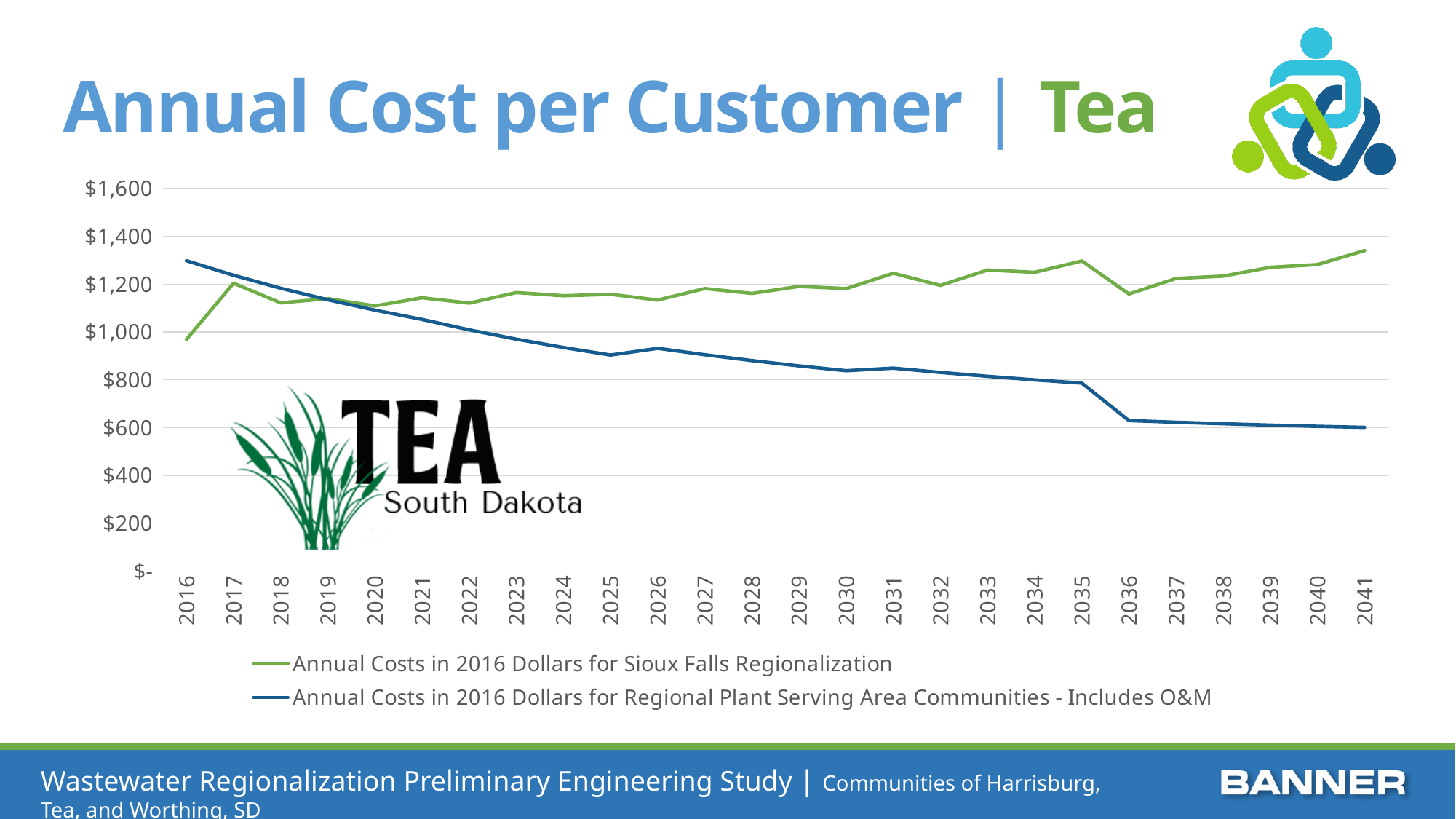
What colour is the line for Annual Costs in 2016 Dollars for Sioux Falls Regionalization? green Is the 2016 value for Regional Plant Serving Area Communities greater or less than $1,400? less Is the 2041 value for Sioux Falls Regionalization greater or less than $1,200? greater How many series does the legend list? 2 Does the line for Annual Costs in 2016 Dollars for Regional Plant Serving Area Communities - Includes O&M rise or fall from 2016 to 2041? fall Does the line for Annual Costs in 2016 Dollars for Sioux Falls Regionalization generally rise or fall from 2016 to 2041? rise In which year is the Sioux Falls Regionalization series at its lowest? 2016 How many years are plotted along the x axis? 26 In 2041, which series has the higher annual cost per customer: Sioux Falls Regionalization or Regional Plant Serving Area Communities? Sioux Falls Regionalization Is the 2016 value for Sioux Falls Regionalization greater or less than $1,000? less In which year is the Regional Plant Serving Area Communities series at its highest? 2016 What kind of chart is shown on the slide? line chart